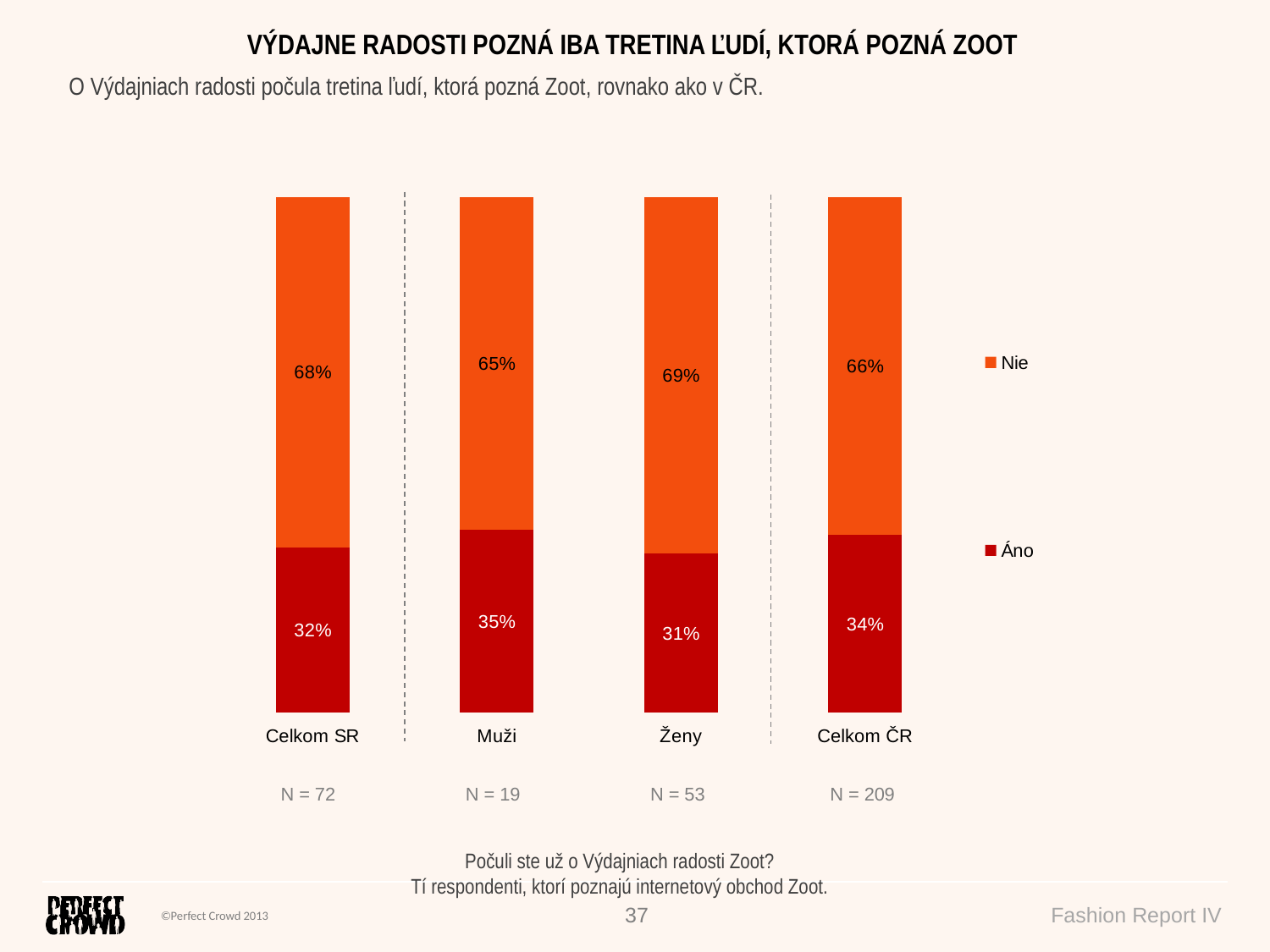
Which is larger: the "Nie" value for Celkom SR or for Celkom ČR? Celkom SR Which category has the highest "Áno" value? Muži What is the total of the stacked bar for Celkom ČR? 100% What kind of chart is shown on the slide? Stacked bar chart Which category has the lowest "Áno" value? Ženy What is the value for "Áno" in the Celkom ČR category? 34% What is the value for "Nie" in the Ženy category? 69% What is the difference between the "Áno" values for Muži and Ženy? 4% How many series does the legend list? 2 What is the value for "Áno" in the Celkom SR category? 32% What is the value for "Nie" in the Muži category? 65% How many categories are shown on the x axis? 4